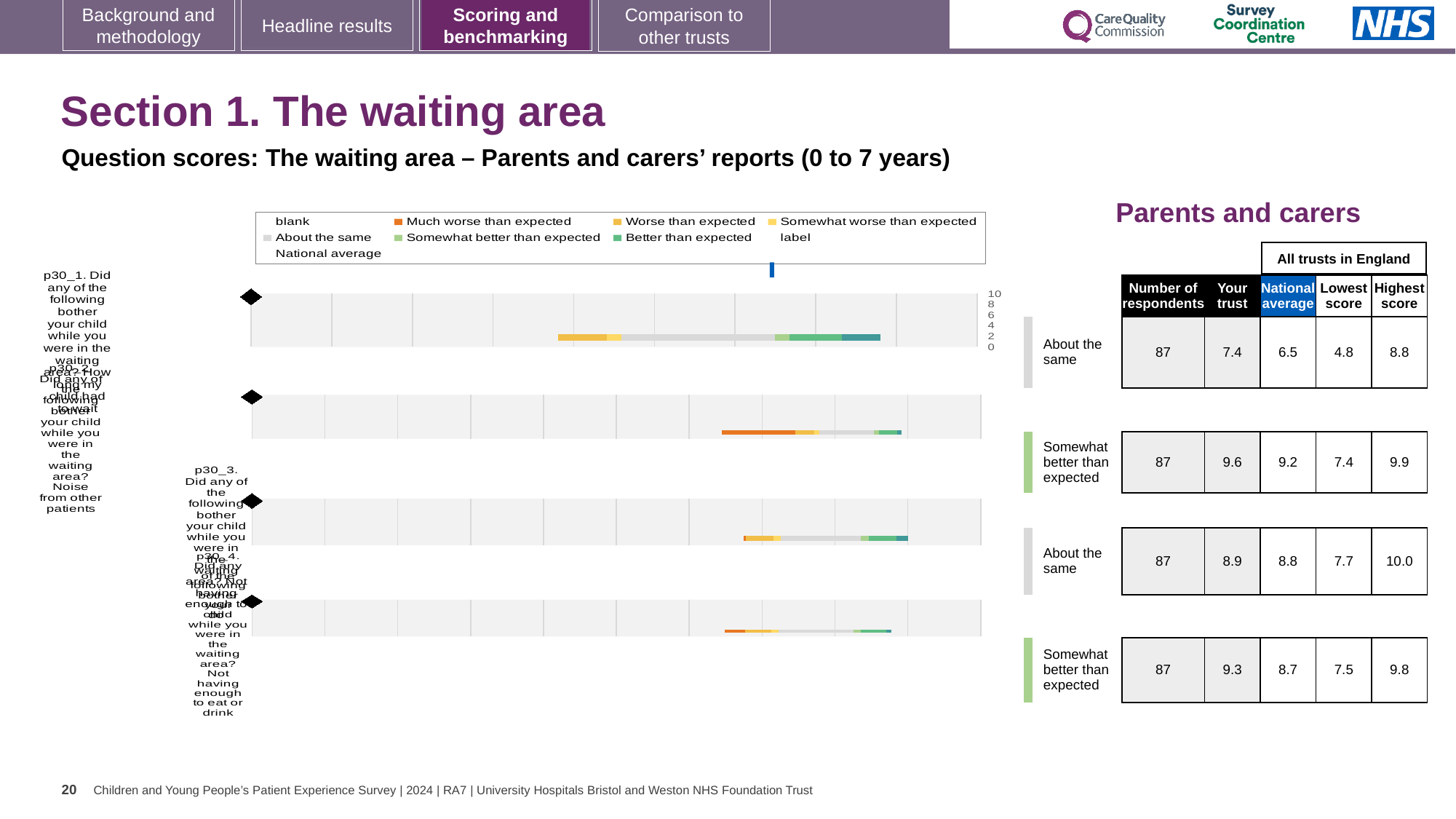
In the table next to the chart, what is the highest score for the third question (p30_3)? 10.0 How many question bars are plotted in the chart? 4 In the table next to the chart, what is the national average for the second question (p30_2)? 9.2 How many respondents are listed for each question in the table? 87 How many entries does the chart legend list? 9 What kind of chart is shown on the slide? bar chart What is the difference between the 'Your trust' score and the national average for the first question (p30_1)? 0.9 In the table next to the chart, what is the 'Your trust' score for the first question (p30_1)? 7.4 In the table next to the chart, what is the lowest score for the fourth question (p30_4)? 7.5 What benchmark category is shown for the fourth question (p30_4)? Somewhat better than expected Which question has the lowest 'Your trust' score in the table? p30_1 Which question has the highest 'Your trust' score in the table? p30_2